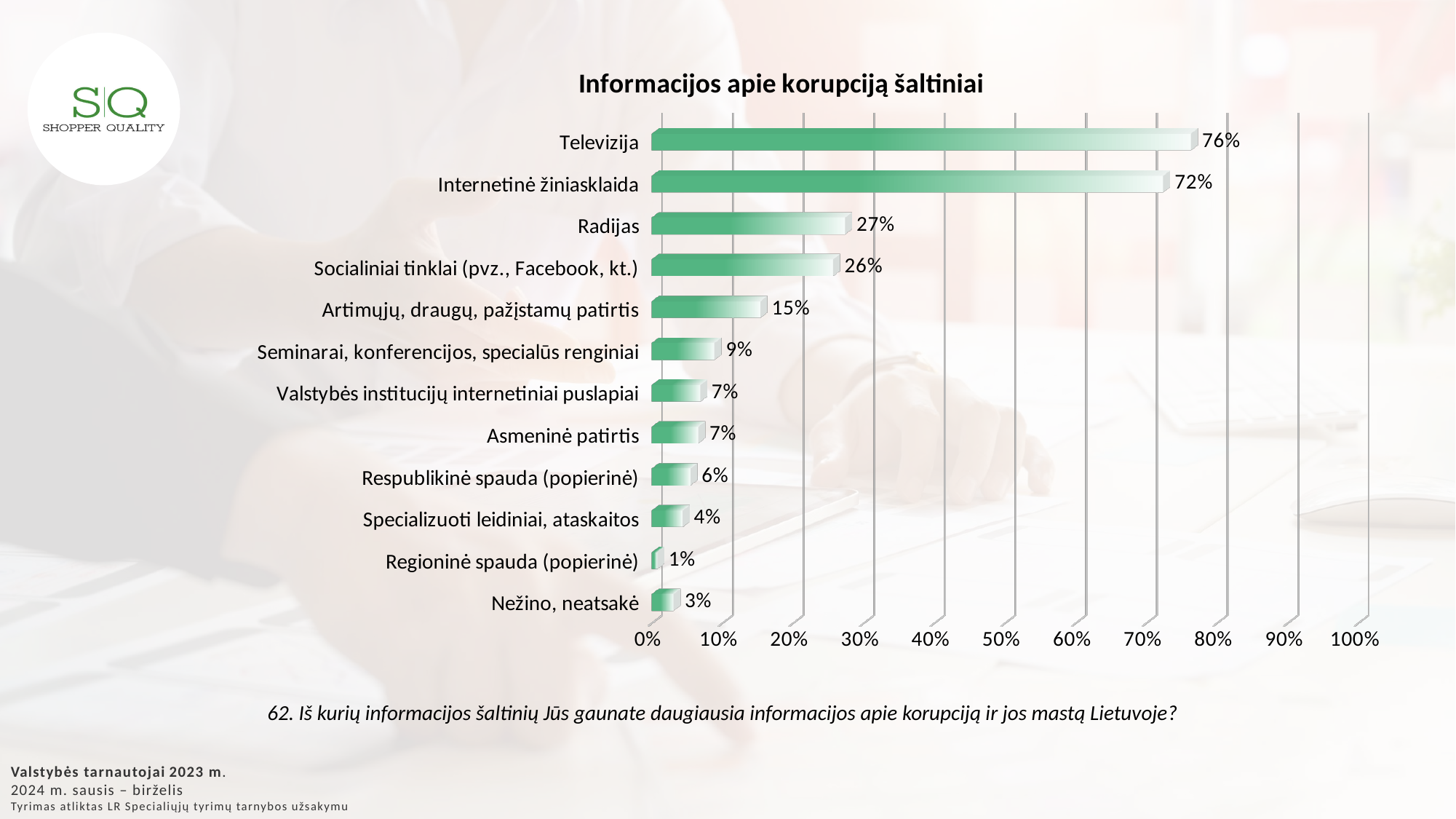
What is the value for Regioninė spauda (popierinė)? 1% What is the value for Televizija? 76% Is the value for Radijas greater or less than 20%? greater How many categories are shown in the chart? 12 Which is larger, the value for Radijas or the value for Artimųjų, draugų, pažįstamų patirtis? Radijas What is the title of the chart? Informacijos apie korupciją šaltiniai What kind of chart is shown on the slide? Bar chart What is the difference between the values for Televizija and Internetinė žiniasklaida? 4% Which category has the lowest value? Regioninė spauda (popierinė) What is the value for Internetinė žiniasklaida? 72% Which category has the highest value? Televizija What is the value for Socialiniai tinklai (pvz., Facebook, kt.)? 26%